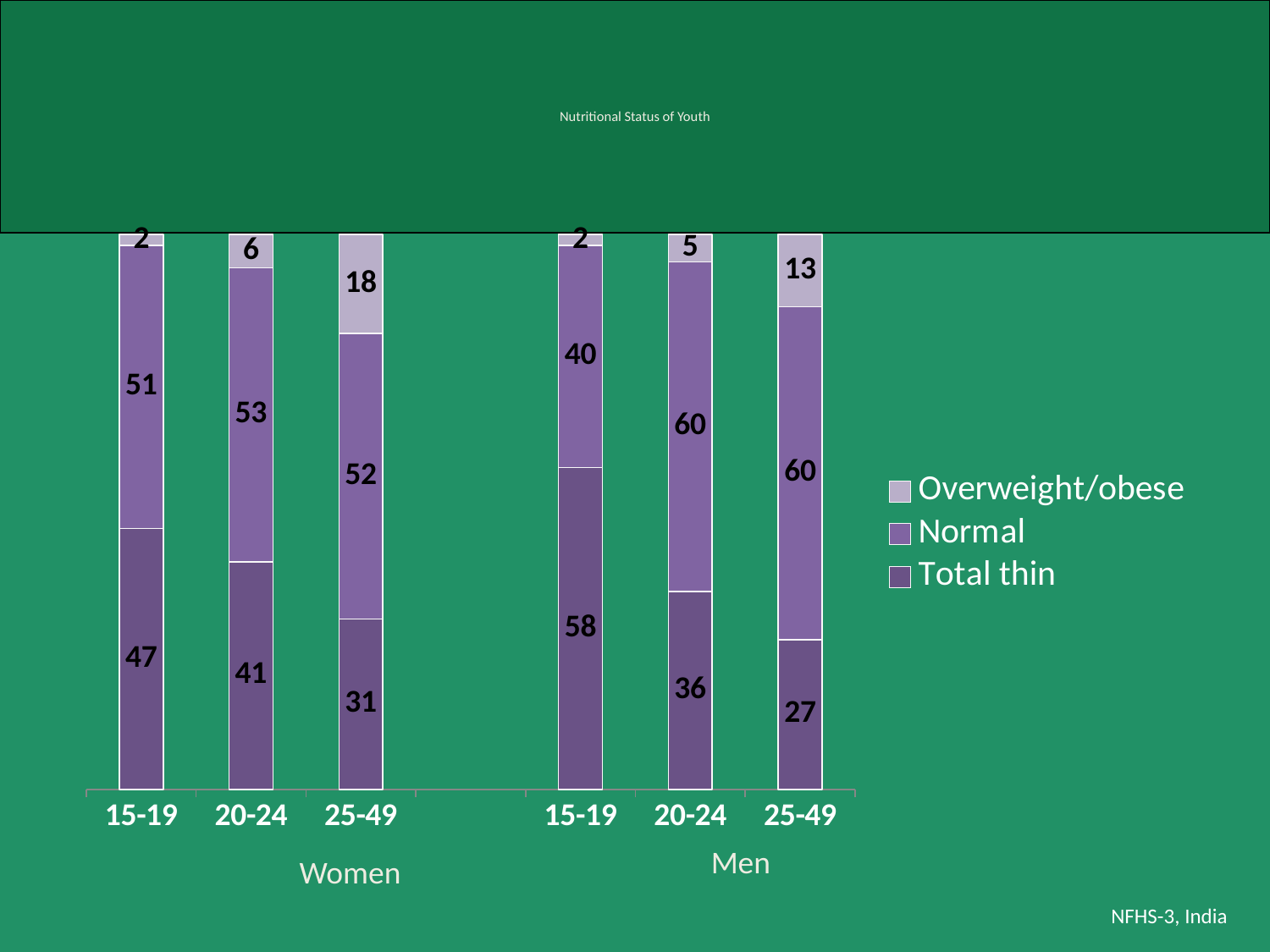
Which is larger: the Overweight/obese value for women aged 25-49 or for men aged 25-49? Women 25-49 Does the Total thin value for men rise or fall across the age groups from 15-19 to 25-49? Fall What is the Overweight/obese value for women aged 25-49? 18 What is the difference between the Total thin values for women aged 15-19 and women aged 25-49? 16 Which group has the lowest Overweight/obese value among women? 15-19 What kind of chart is shown on the slide? Stacked bar chart What is the Normal value for men aged 20-24? 60 How many series does the legend list? 3 What is the Total thin value for men aged 25-49? 27 How many age-group bars are plotted in the chart? 6 What is the Total thin value for women aged 15-19? 47 Which group has the highest Total thin value? Men 15-19